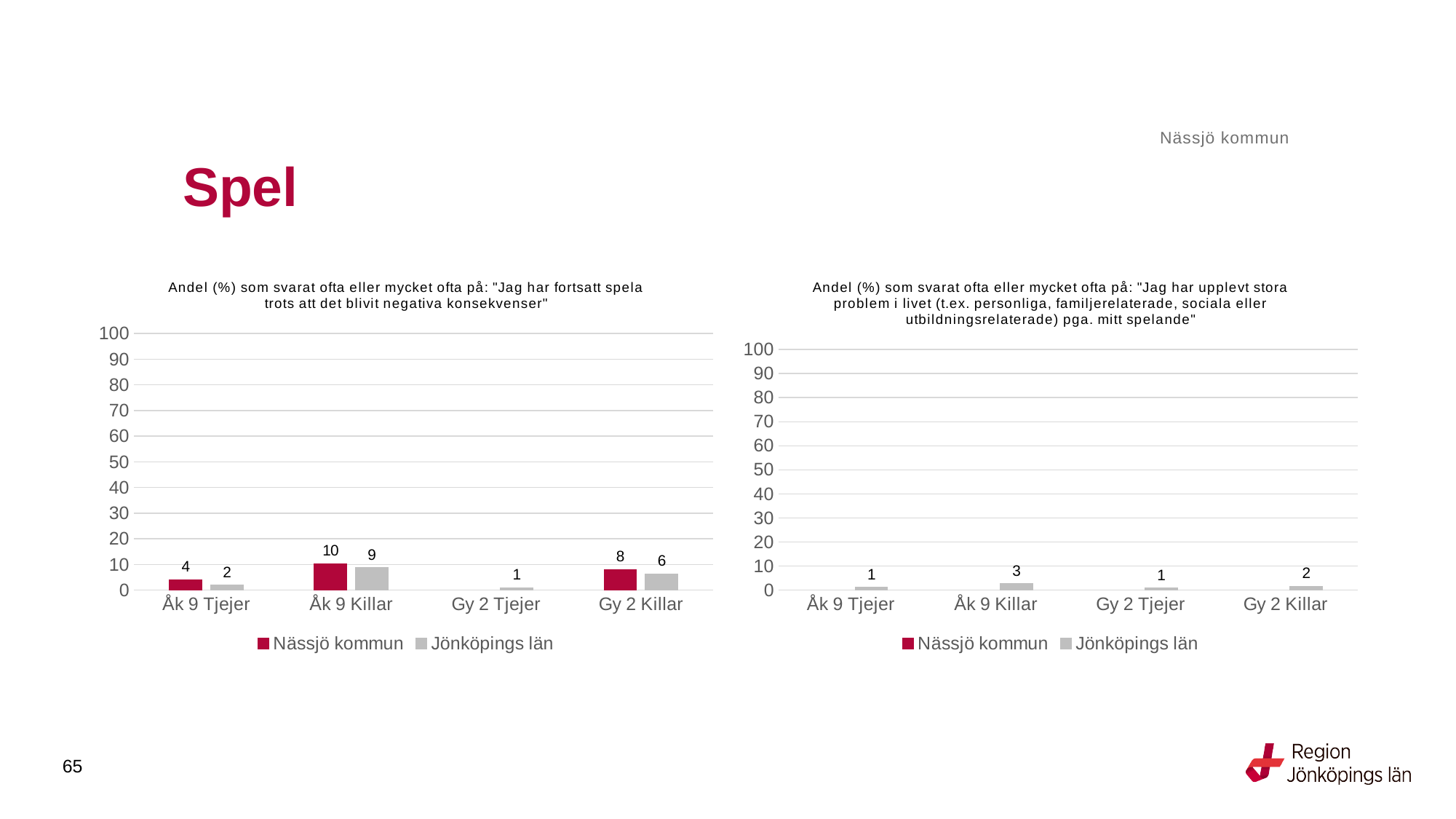
In the left chart, what is the value for Jönköpings län for Gy 2 Killar? 6 In the right chart, which category has the highest value for Jönköpings län? Åk 9 Killar In the right chart, what is the value for Jönköpings län for Åk 9 Killar? 3 In the left chart, what is the value for Nässjö kommun for Åk 9 Killar? 10 In the left chart, which category has the highest value for Nässjö kommun? Åk 9 Killar In the left chart, what is the difference between Nässjö kommun and Jönköpings län for Gy 2 Killar? 2 In the left chart, which is larger for Åk 9 Tjejer: Nässjö kommun or Jönköpings län? Nässjö kommun How many categories are shown on the x axis of the left chart? 4 How many series does the legend of the right chart list? 2 In the left chart, what is the value for Jönköpings län for Åk 9 Tjejer? 2 In the right chart, what is the value for Jönköpings län for Gy 2 Killar? 2 What kind of chart is the left chart? Bar chart